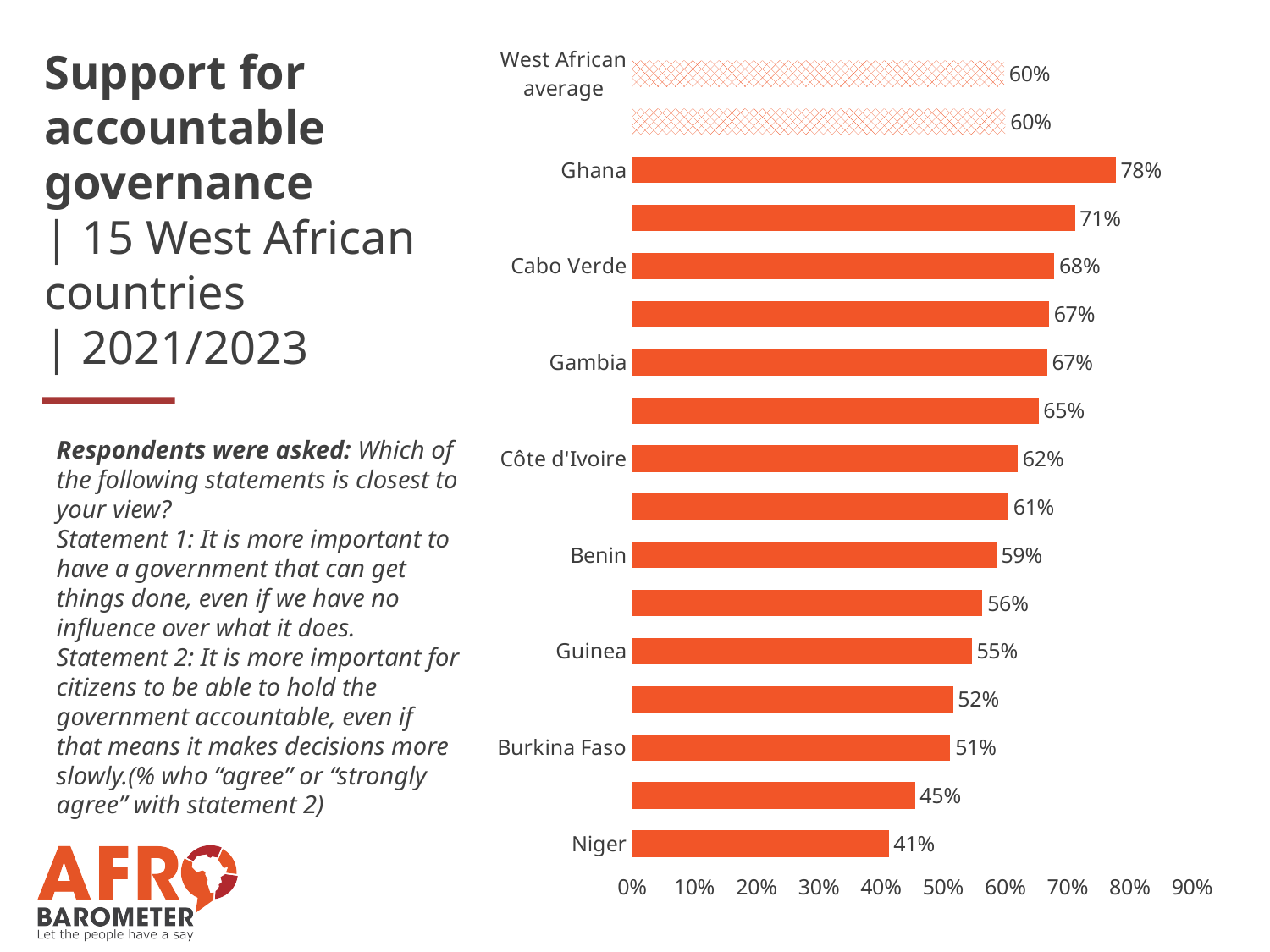
What is the value for Burkina Faso? 51% How many bars are plotted in the chart? 17 Which labelled country has the lowest value? Niger What is the value for the West African average? 60% What is the value for Niger? 41% What is the value for Ghana? 78% Which labelled country has the highest value? Ghana What kind of chart is shown on the slide? Bar chart What is the difference between the values for Ghana and Niger? 37 percentage points Which is larger, the value for Cabo Verde or the value for Guinea? Cabo Verde What is the value for Gambia? 67% Is the value for Benin greater or less than 60%? less